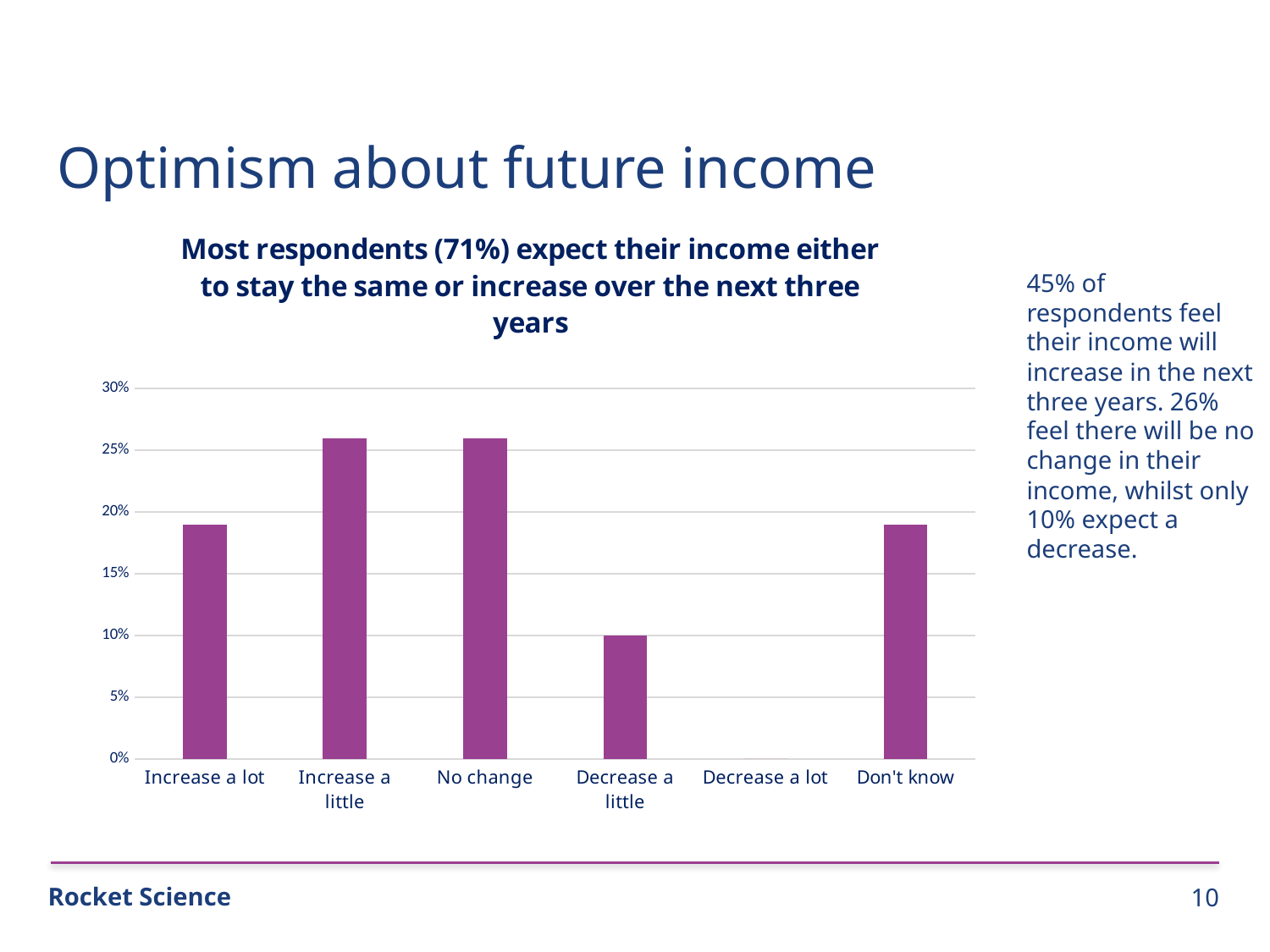
What is the value for 'Decrease a lot'? 0% Which is larger, the value for 'Increase a lot' or the value for 'Decrease a little'? Increase a lot What is the title of the chart? Most respondents (71%) expect their income either to stay the same or increase over the next three years What kind of chart is shown on the slide? bar chart What is the value for 'Decrease a little'? 10% Which category has the lowest value in the chart? Decrease a lot Is the value for 'Increase a lot' greater or less than 15%? greater Is the value for 'No change' greater or less than 25%? greater Is the value for 'Don't know' greater or less than 20%? less Which is larger, the value for 'No change' or the value for 'Don't know'? No change How many categories are shown on the x axis of the chart? 6